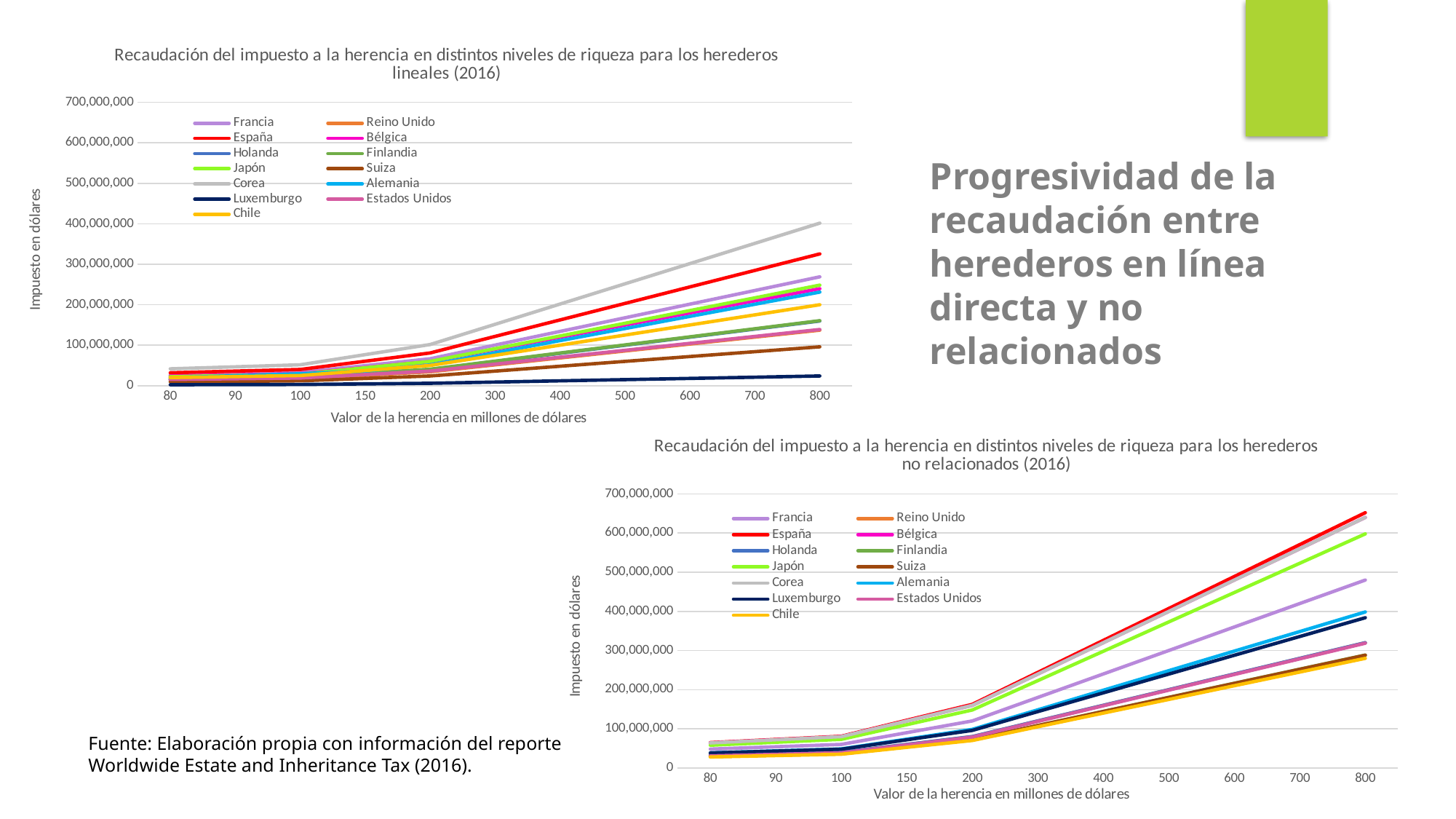
In the top chart ('herederos lineales'), is the value for Luxemburgo at 800 greater or less than 100,000,000? less In the bottom chart ('herederos no relacionados'), which is larger at 800: Japón or Francia? Japón In the top chart ('herederos lineales'), is the value for Corea at 800 greater or less than 300,000,000? greater What kind of chart is the top chart, 'Recaudación del impuesto a la herencia ... herederos lineales (2016)'? line chart In the bottom chart ('herederos no relacionados'), is the value for Japón at 800 greater or less than 500,000,000? greater In the top chart ('herederos lineales'), which country has the highest tax collection at an inheritance value of 800? Corea How many series does the legend of the bottom chart ('herederos no relacionados (2016)') list? 13 In the bottom chart ('herederos no relacionados'), do the values for España rise or fall as the inheritance value increases from 80 to 800? rise How many inheritance-value points are shown on the x axis of the top chart ('herederos lineales')? 11 In the top chart ('herederos lineales'), which country has the lowest tax collection at an inheritance value of 800? Luxemburgo In the top chart ('herederos lineales'), which is larger at 800: Corea or España? Corea